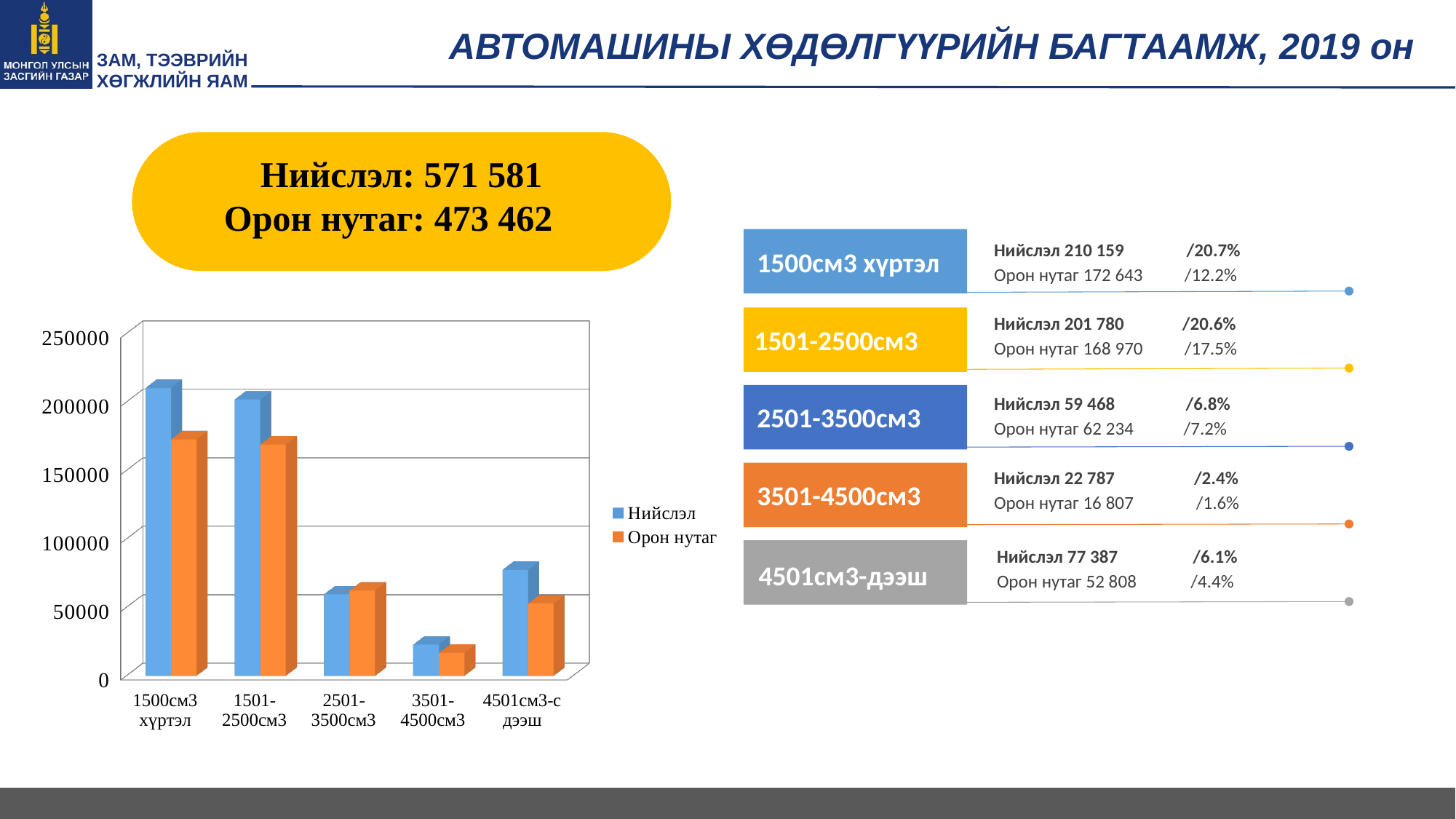
Is the Нийслэл value for 1500см3 хүртэл greater or less than 200000? greater How many engine-capacity categories are shown on the x axis of the chart? 5 Is the Орон нутаг value for 3501-4500см3 greater or less than 50000? less Which category has the lowest Орон нутаг bar in the chart? 3501-4500см3 How many series does the chart legend list? 2 Which category has the lowest Нийслэл bar in the chart? 3501-4500см3 According to the figures printed on the slide, what is the Нийслэл value for 1501-2500см3? 201 780 According to the figures printed on the slide, what is the Орон нутаг value for 2501-3500см3? 62 234 What kind of chart is shown on the slide? bar chart For the 4501см3-с дээш category, which series has the larger bar, Нийслэл or Орон нутаг? Нийслэл What are the two entries in the chart legend? Нийслэл and Орон нутаг Using the figures printed on the slide, what is the difference between the Нийслэл and Орон нутаг values for 1500см3 хүртэл? 37 516